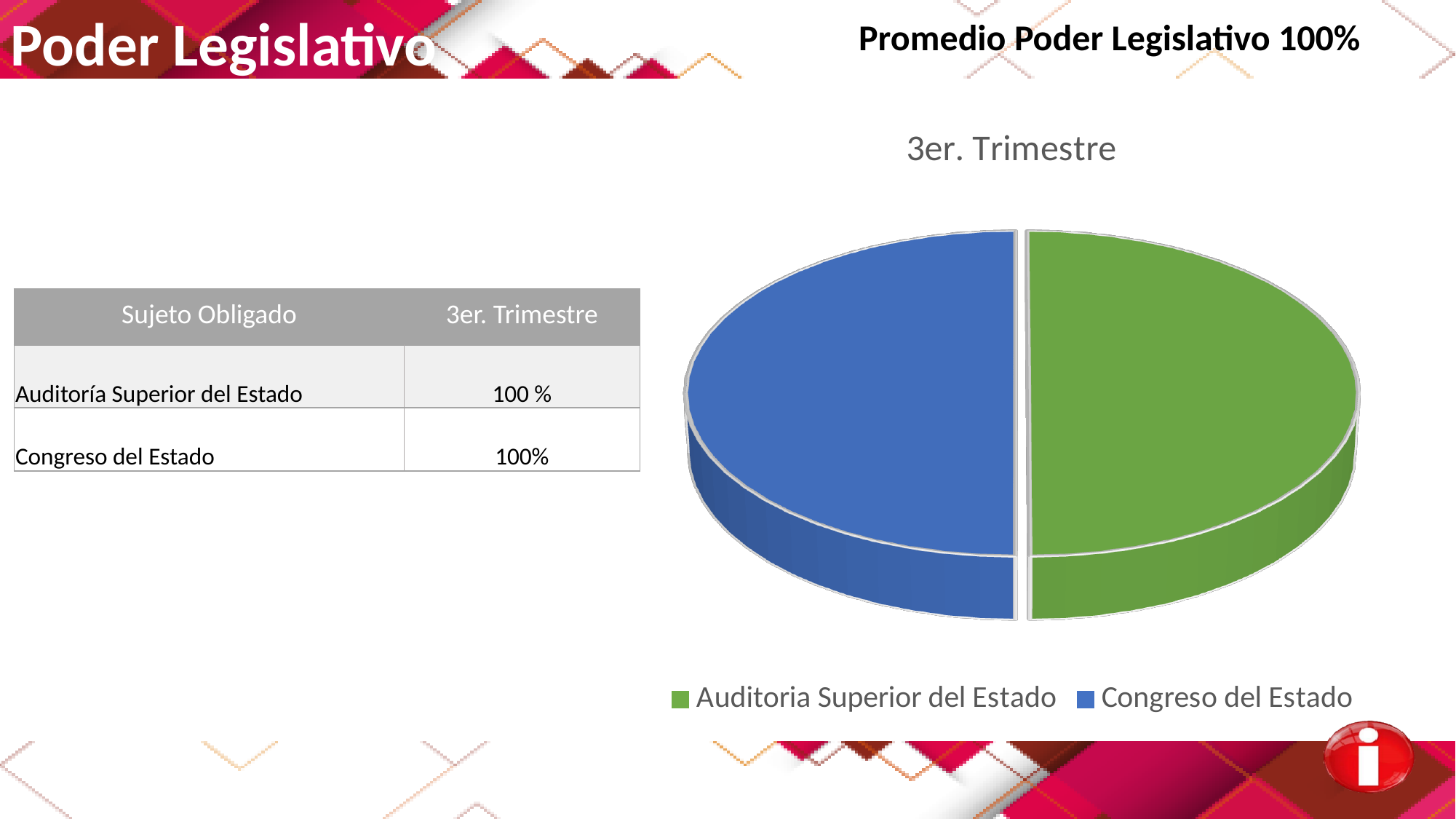
What is the title of the pie chart? 3er. Trimestre How many slices does the pie chart have? 2 Which colour represents Congreso del Estado in the pie chart? blue What kind of chart is shown on the slide? pie chart How many entries does the legend of the pie chart list? 2 Which two categories are listed in the legend of the pie chart? Auditoria Superior del Estado and Congreso del Estado Which category is shown in green in the pie chart? Auditoria Superior del Estado